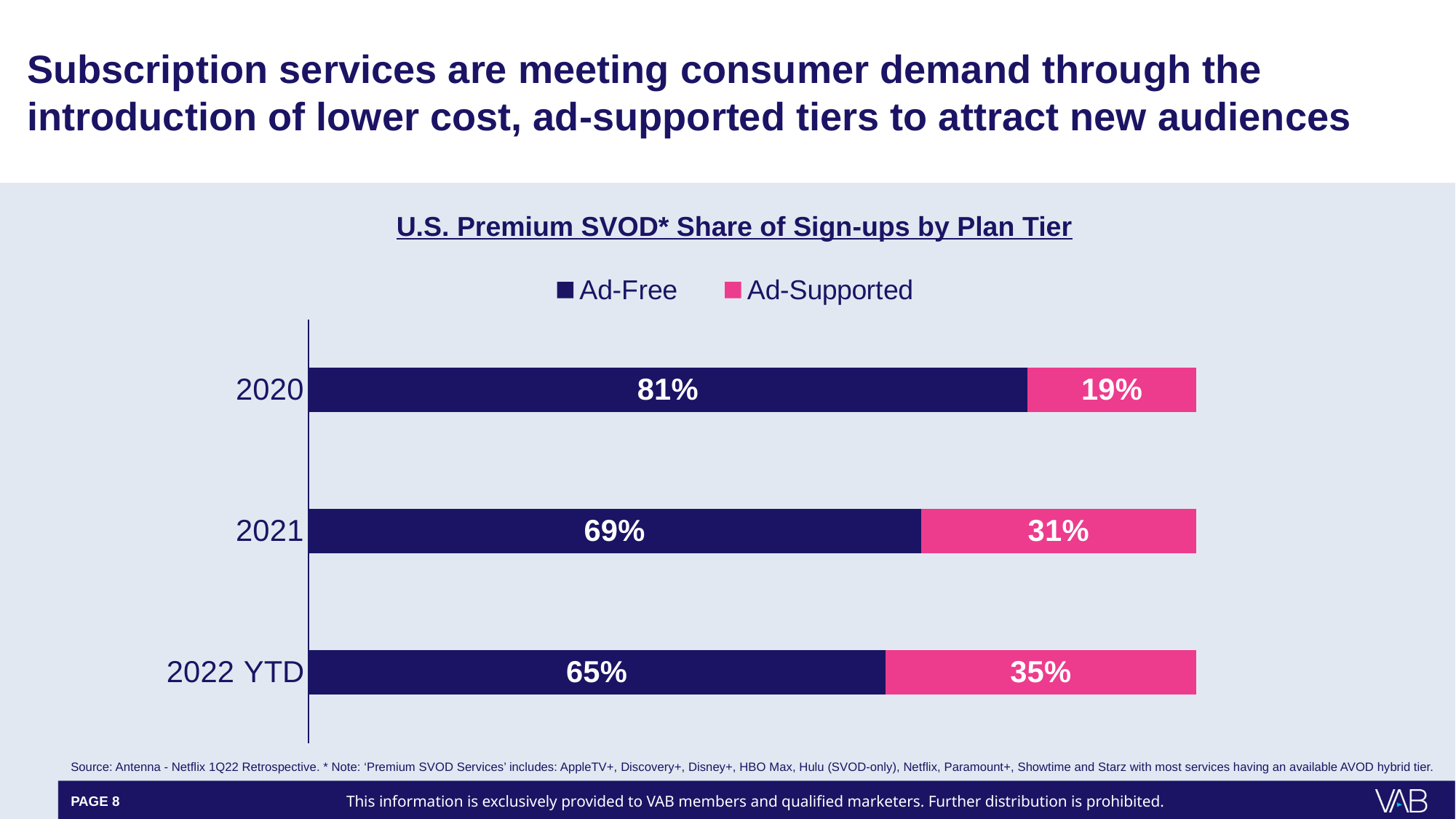
What is the difference between the Ad-Free share in 2020 and the Ad-Free share in 2022 YTD? 16% How many time periods are shown on the chart? 3 What is the Ad-Supported share of sign-ups for 2022 YTD? 35% Which year has the lowest Ad-Free share of sign-ups? 2022 YTD How many series does the legend list? 2 Does the Ad-Supported share rise or fall from 2020 to 2022 YTD? Rise What is the Ad-Free share of sign-ups for 2020? 81% What is the Ad-Supported share of sign-ups for 2021? 31% Which year has the highest Ad-Supported share of sign-ups? 2022 YTD What kind of chart is shown on the slide? Stacked bar chart What is the title of the chart? U.S. Premium SVOD* Share of Sign-ups by Plan Tier Which is larger: the Ad-Supported share in 2020 or the Ad-Supported share in 2021? 2021